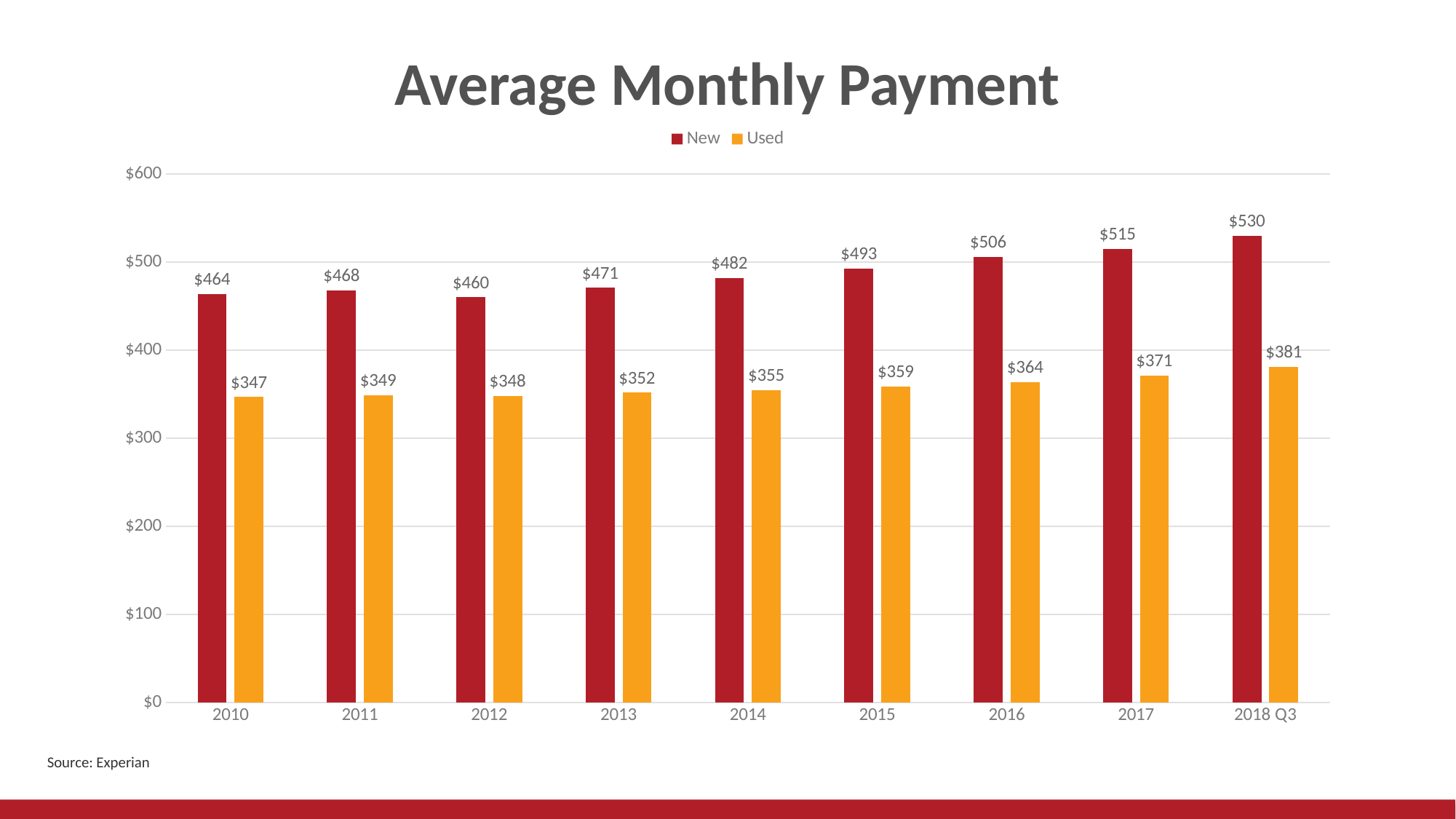
How many years or periods are shown on the x axis? 9 What kind of chart is shown on the slide? Bar chart What is the average monthly payment for Used vehicles in 2017? $371 What is the average monthly payment for New vehicles in 2014? $482 How many series does the legend list? 2 Do the Used vehicle payments rise or fall from 2012 to 2018 Q3? Rise What is the title of the chart? Average Monthly Payment Which year has the lowest average monthly payment for Used vehicles? 2010 What is the difference between the New and Used average monthly payments in 2018 Q3? $149 Which is larger, the New payment in 2012 or the New payment in 2011? 2011 Which year has the highest average monthly payment for New vehicles? 2018 Q3 What colour represents the Used series in the chart? Orange